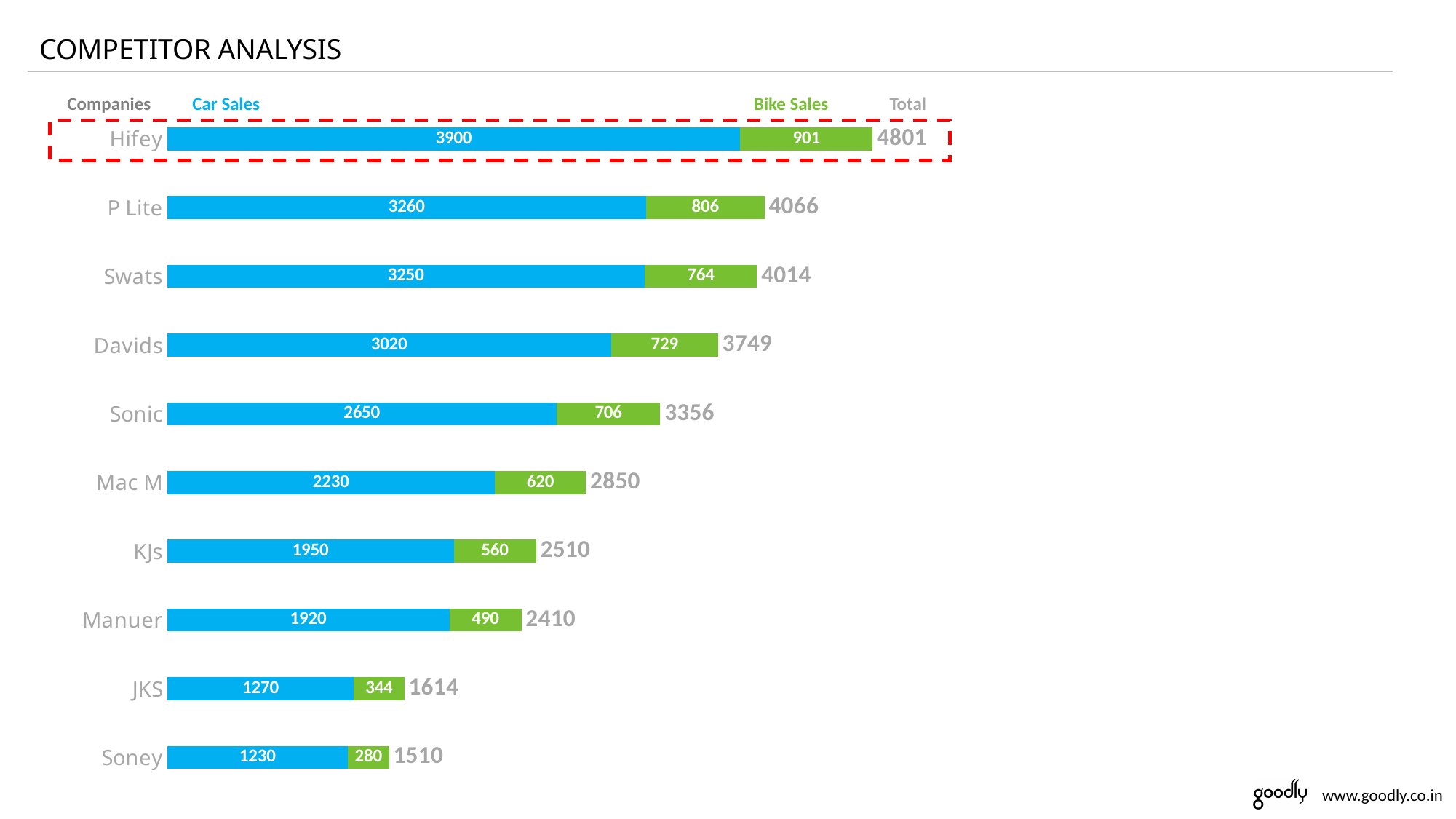
Which company is highlighted with a red dashed box? Hifey Which company has the lowest Bike Sales? Soney What is the Total for Manuer? 2410 Which is larger, the Bike Sales of Davids or the Bike Sales of Mac M? Davids How many companies are shown in the chart? 10 What is the difference between the Car Sales of P Lite and Swats? 10 What is the total of the stacked bar for JKS? 1614 What kind of chart is shown on the slide? Stacked bar chart What is the Car Sales value for Hifey? 3900 What is the Bike Sales value for Sonic? 706 How many series does the chart show? 2 Which company has the highest Total? Hifey